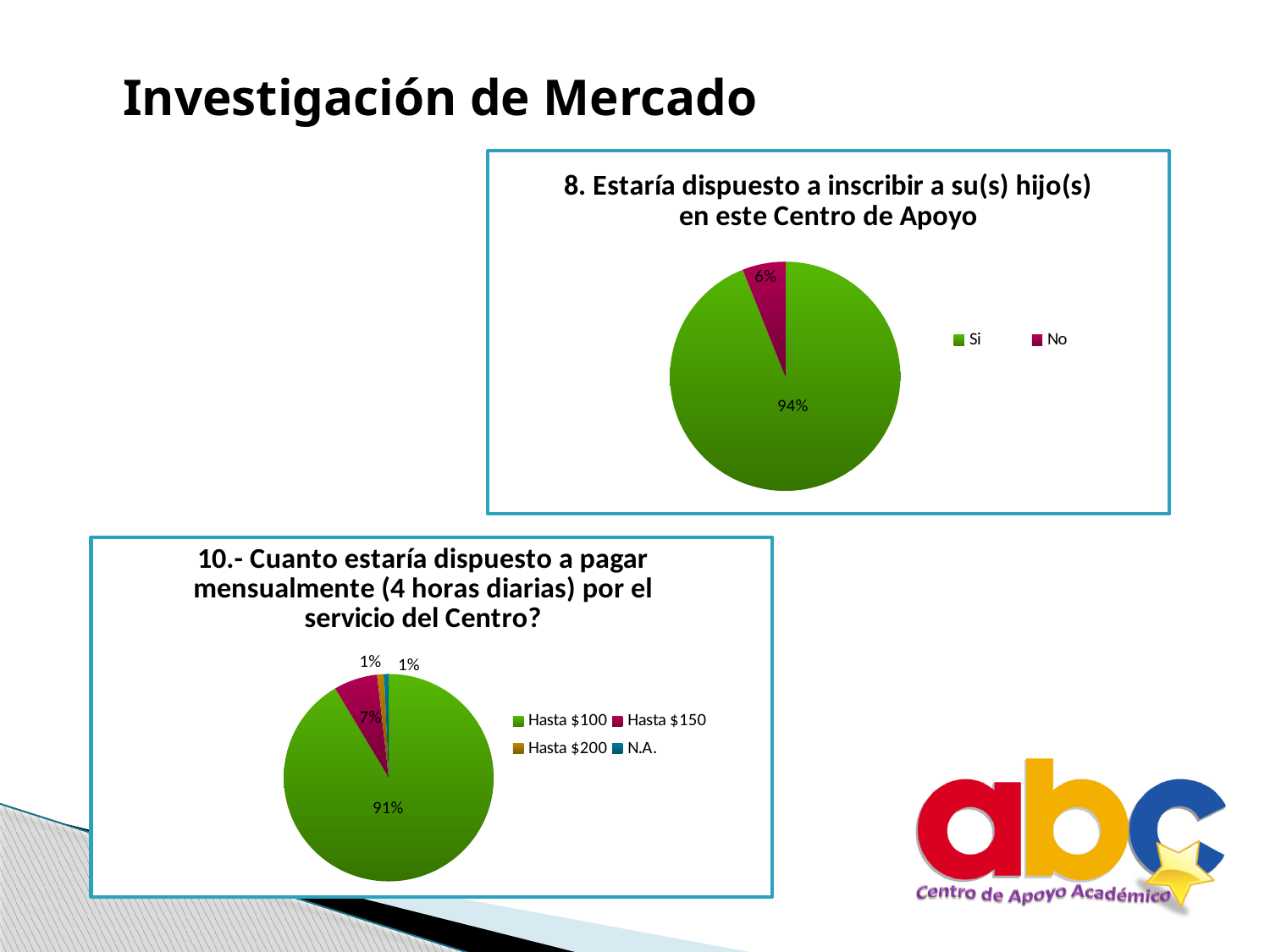
What kind of chart is the top chart (question 8)? Pie chart In the bottom chart (question 10), which is larger, 'Hasta $100' or 'Hasta $150'? Hasta $100 In the chart titled '8. Estaría dispuesto a inscribir a su(s) hijo(s) en este Centro de Apoyo', what share of the pie is 'No'? 6% In the top chart (question 8), what is the difference between the 'Si' and 'No' shares? 88% In the chart titled '10.- Cuanto estaría dispuesto a pagar mensualmente (4 horas diarias) por el servicio del Centro?', what share of the pie is 'Hasta $100'? 91% In the bottom chart (question 10), how many categories does the legend list? 4 In the bottom chart (question 10), what share of the pie is 'Hasta $150'? 7% In the top chart (question 8), how many categories does the legend list? 2 In the bottom chart (question 10), what colour is the 'Hasta $100' slice? Green In the top chart (question 8), which category has the largest slice? Si